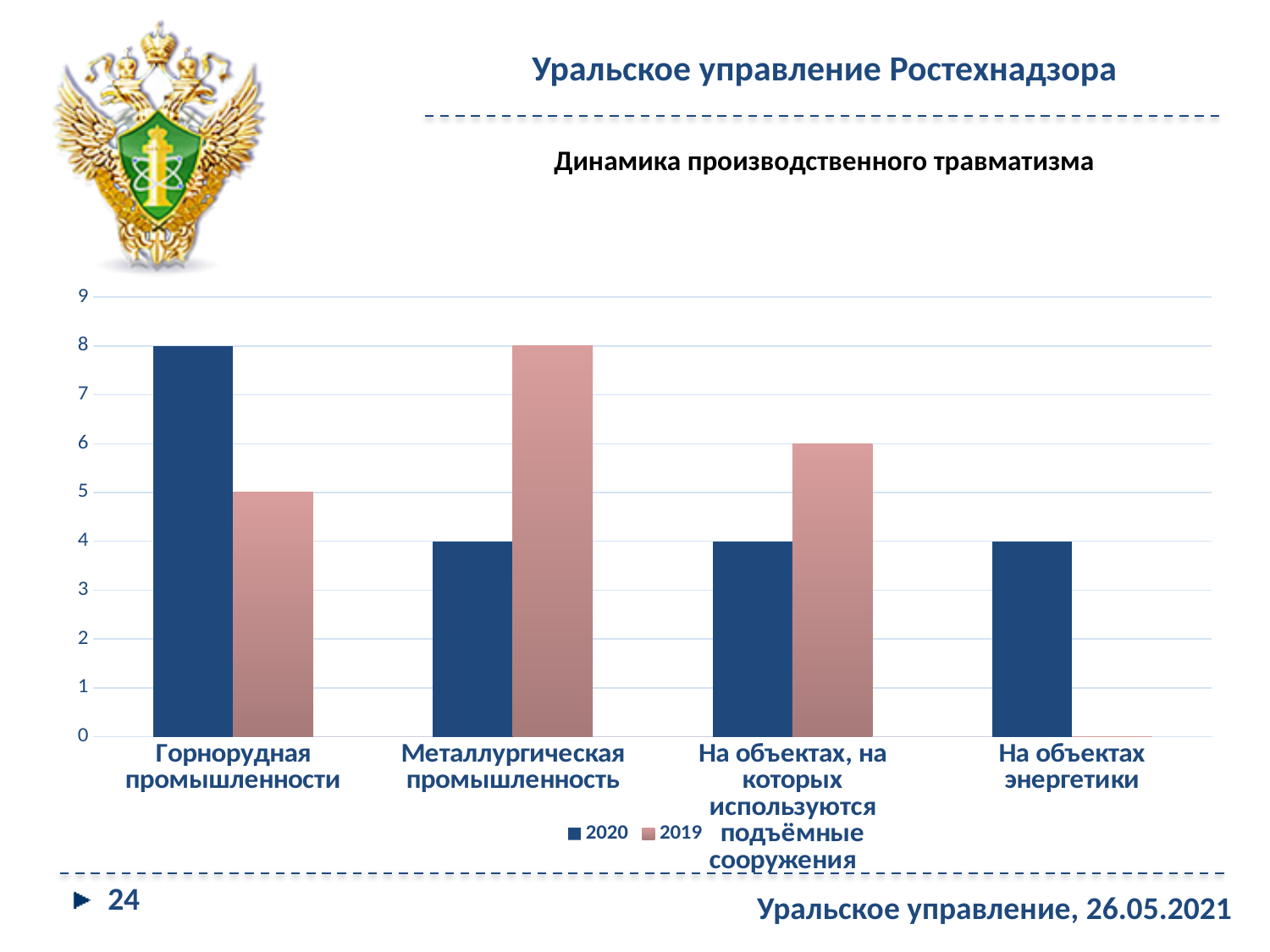
Which category has the lowest value for 2019? На объектах энергетики Which category has the highest value for 2019? Металлургическая промышленность What is the difference between the 2019 and 2020 values in the category На объектах, на которых используются подъёмные сооружения? 2 What is the value for 2020 in the category На объектах энергетики? 4 What is the value for 2019 in the category Горнорудная промышленности? 5 Which is larger in the category Металлургическая промышленность, the 2020 value or the 2019 value? 2019 How many categories are shown on the x axis? 4 What is the value for 2019 in the category Металлургическая промышленность? 8 How many series does the legend list? 2 What is the title of the chart? Динамика производственного травматизма What kind of chart is shown on the slide? bar chart What is the value for 2020 in the category Горнорудная промышленности? 8